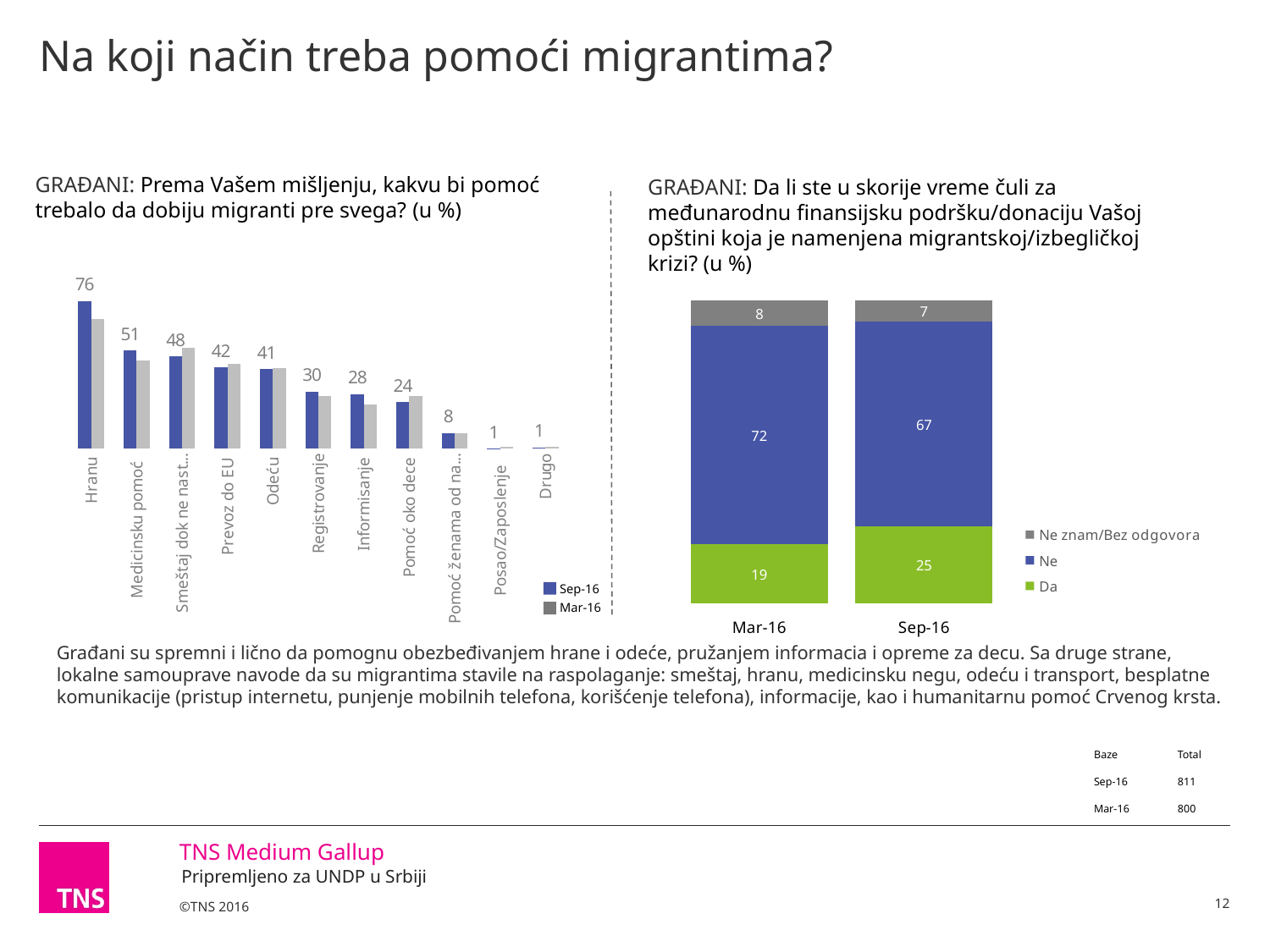
In the left chart, which is larger for Sep-16: Registrovanje or Informisanje? Registrovanje How many series does the legend of the right chart list? 3 In the left chart, what is the Sep-16 value for Prevoz do EU? 42 In the right chart, what is the total of the Sep-16 stacked bar? 99 How many series does the legend of the left chart list? 2 In the left chart, what is the Sep-16 value for Hranu? 76 How many categories are shown in the left chart? 11 What kind of chart is the left chart? Bar chart In the right chart, what is the value for Ne in Mar-16? 72 In the left chart, what is the difference between the Sep-16 values for Hranu and Medicinsku pomoć? 25 In the right chart, what is the value for Da in Sep-16? 25 In the left chart, which category has the highest Sep-16 value? Hranu